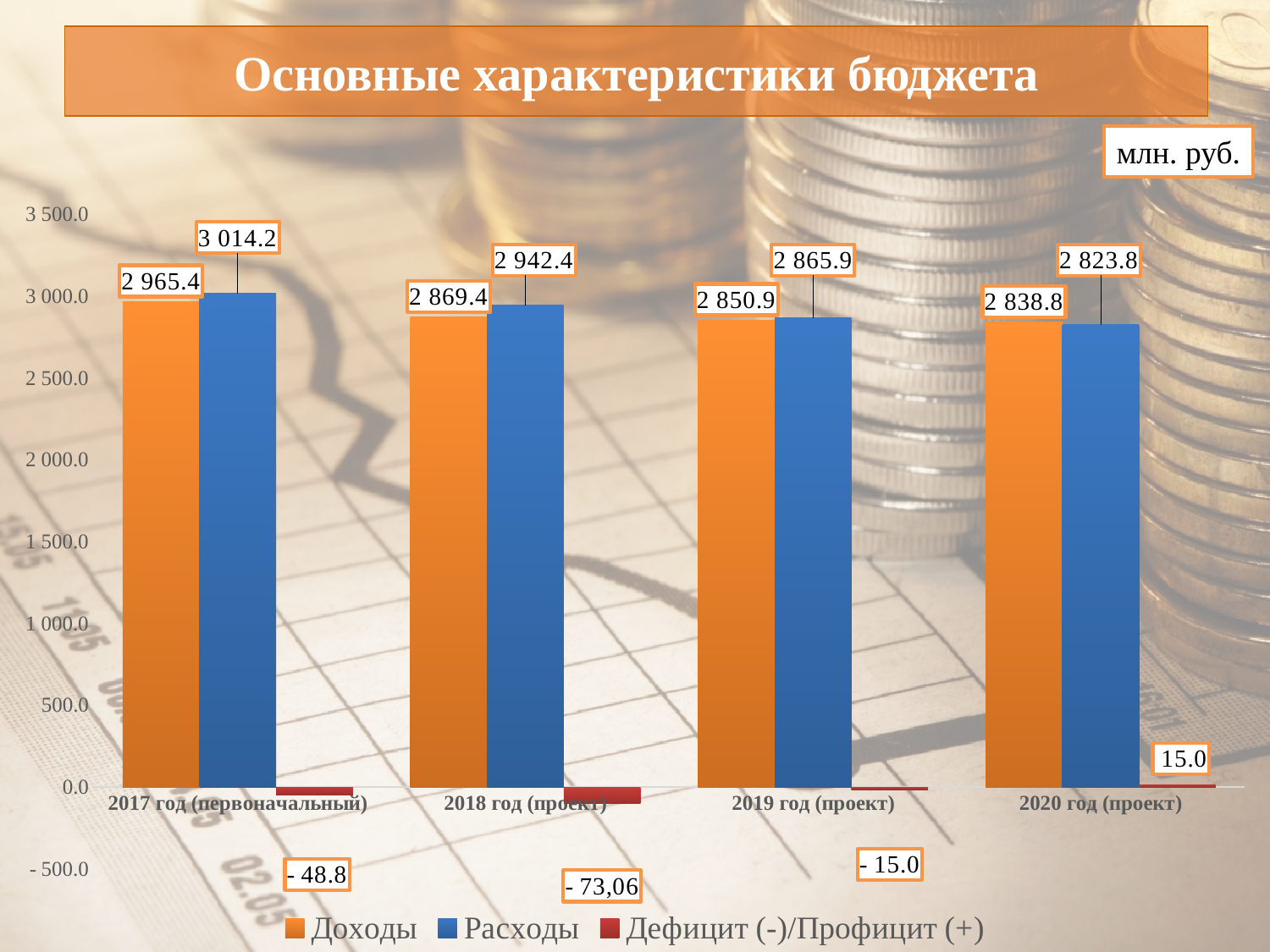
How many series does the legend list? 3 What is the value of Дефицит (-)/Профицит (+) for 2020 год (проект)? 15.0 Which year has the lowest value of Доходы? 2020 год (проект) What unit is indicated in the box at the top right of the chart? млн. руб. Do the Доходы values rise or fall from 2017 to 2020? fall How many year categories are shown on the x axis? 4 Which year has the highest value of Расходы? 2017 год (первоначальный) What is the value of Расходы for 2018 год (проект)? 2 942.4 What is the value of Дефицит (-)/Профицит (+) for 2019 год (проект)? - 15.0 What is the value of Доходы for 2017 год (первоначальный)? 2 965.4 What is the difference between Расходы and Доходы for 2017 год (первоначальный)? 48.8 What type of chart is shown on the slide? bar chart